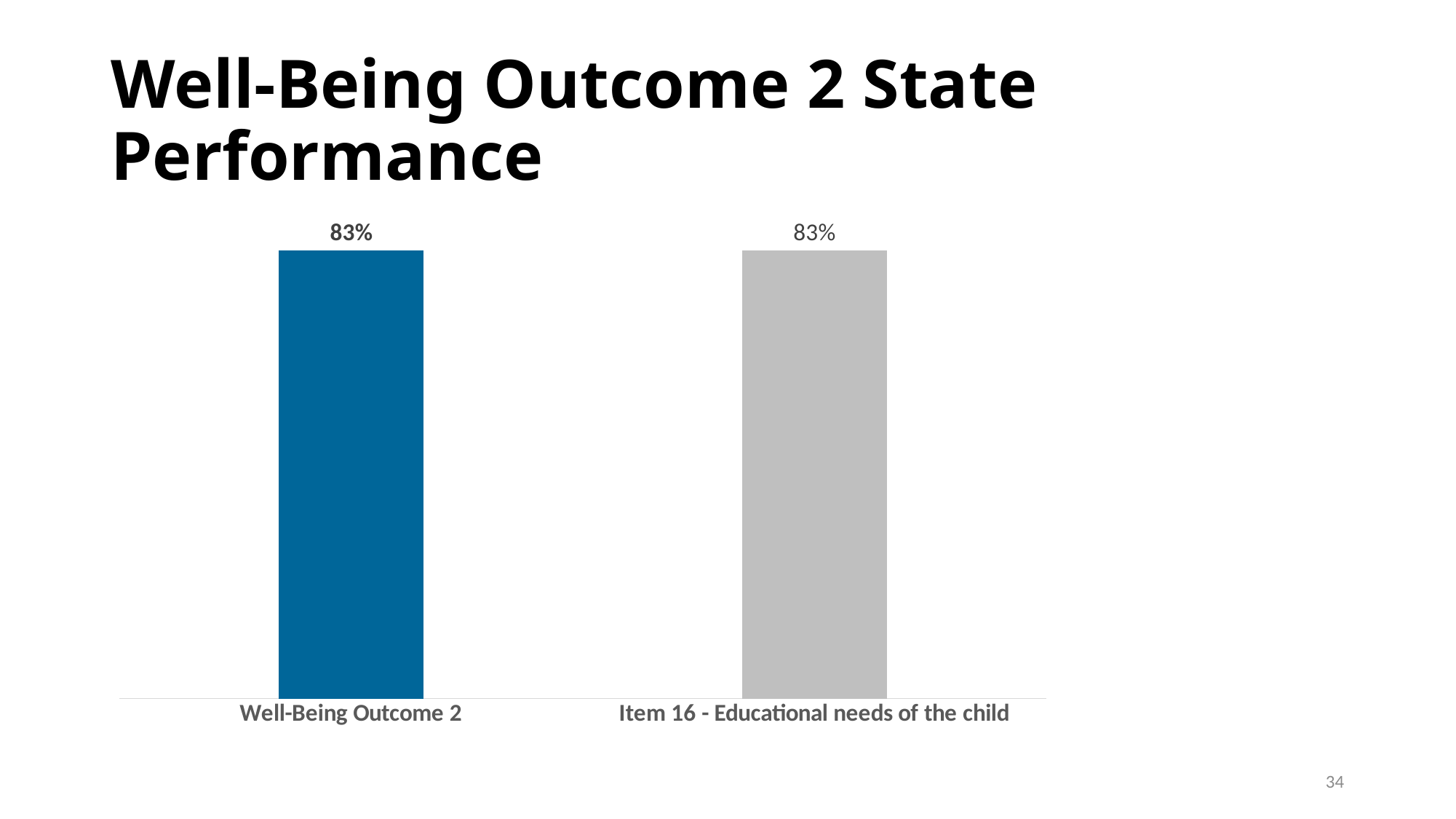
What is the title of the slide? Well-Being Outcome 2 State Performance What kind of chart is shown on the slide? Bar chart Is the value for Item 16 - Educational needs of the child greater or less than 90%? less What is the value for Item 16 - Educational needs of the child? 83% What is the value for Well-Being Outcome 2? 83% Is the value for Well-Being Outcome 2 greater or less than 50%? greater What is the difference between the values for Well-Being Outcome 2 and Item 16 - Educational needs of the child? 0% What colour is the bar for Well-Being Outcome 2? Blue Do the two bars in the chart have the same value? Yes How many bars are shown in the chart? 2